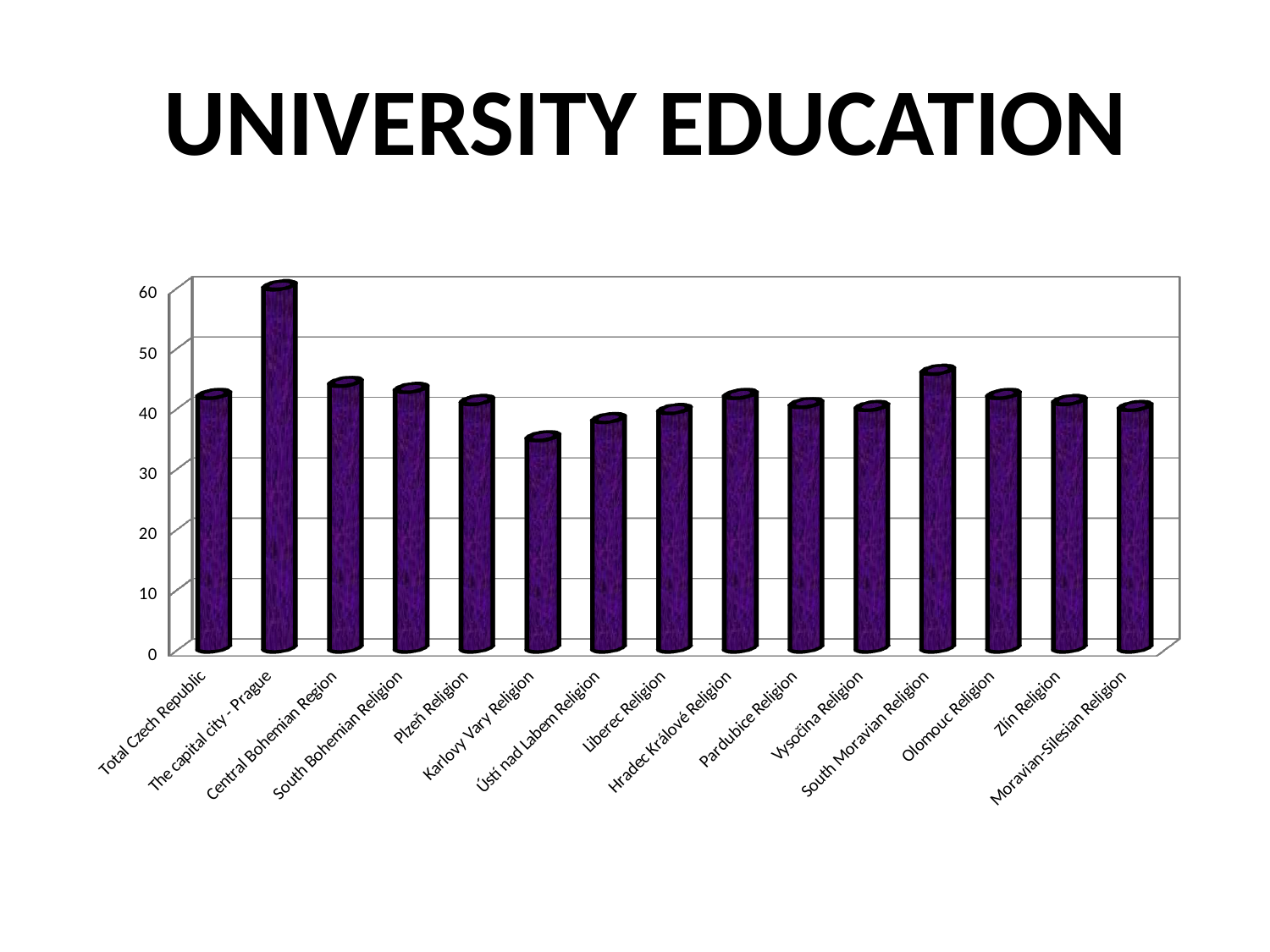
Is the value for South Moravian Religion greater or less than 40? greater Is the value for The capital city - Prague greater or less than 50? greater Which category has the highest bar on the chart? The capital city - Prague How many regions (categories) are plotted on the chart? 15 What is the title shown above the chart on the slide? UNIVERSITY EDUCATION What colour are the bars on the chart? purple Which is larger, the value for South Moravian Religion or the value for Karlovy Vary Religion? South Moravian Religion Is the value for Karlovy Vary Religion greater or less than 40? less What kind of chart is shown on the slide? bar chart Which category has the lowest bar on the chart? Karlovy Vary Religion Which is larger, the value for The capital city - Prague or the value for Central Bohemian Region? The capital city - Prague